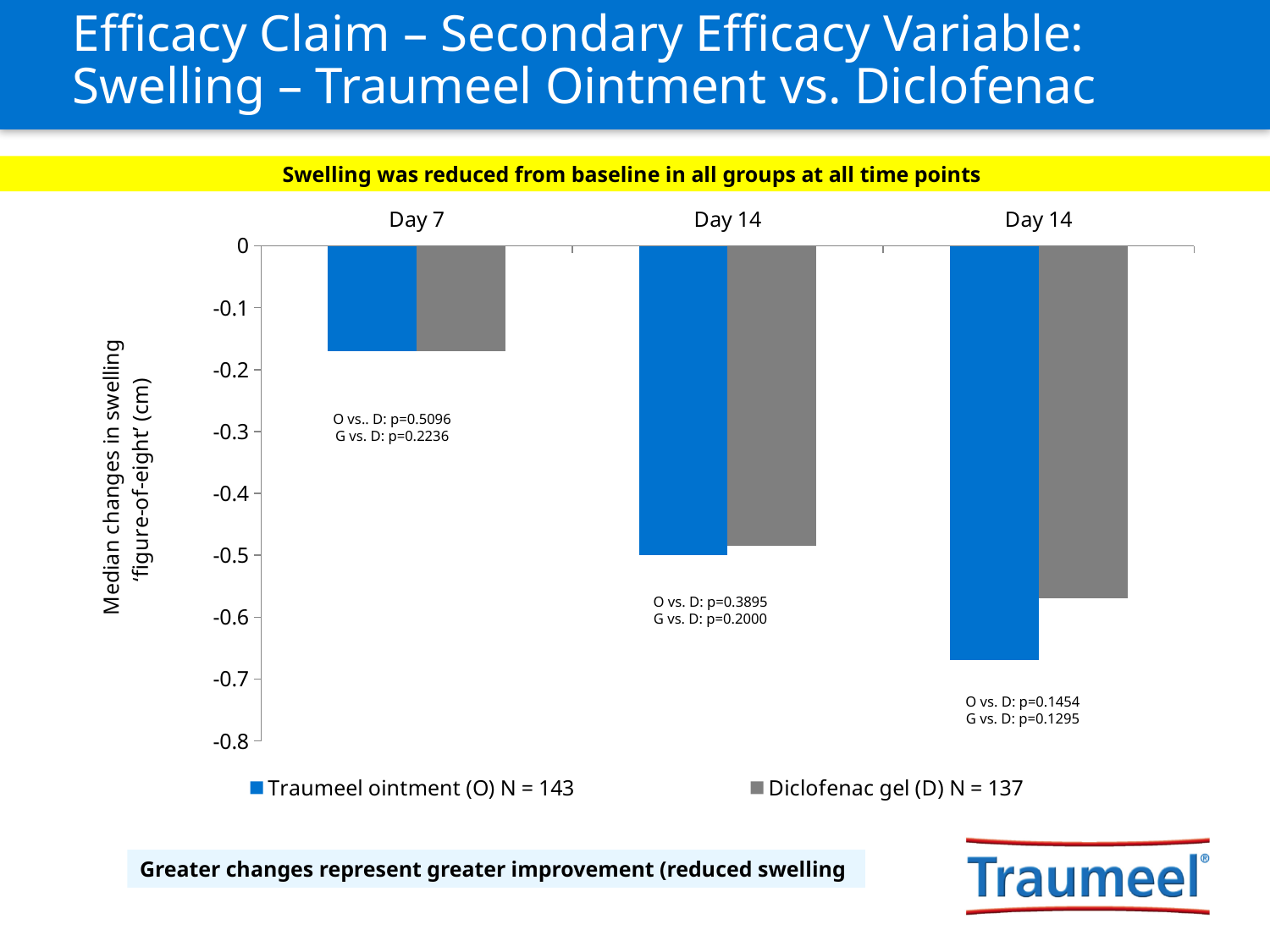
What is the legend entry for the blue series? Traumeel ointment (O) N = 143 What is the legend entry for the grey series? Diclofenac gel (D) N = 137 How many series does the legend list? 2 Is the value for Traumeel ointment at Day 7 greater or less than -0.2? greater In the rightmost Day 14 group, which series shows the larger reduction in swelling (the longer bar)? Traumeel ointment (O) What kind of chart is shown on the slide? Bar chart Do the Traumeel ointment values rise or fall moving from left to right across the groups? Fall Is the value for Traumeel ointment in the middle Day 14 group greater or less than -0.4? less Is the value for Traumeel ointment in the rightmost Day 14 group greater or less than -0.6? less Which group of bars shows the largest reduction in swelling for Traumeel ointment? The rightmost Day 14 group How many groups of bars are plotted along the x axis? 3